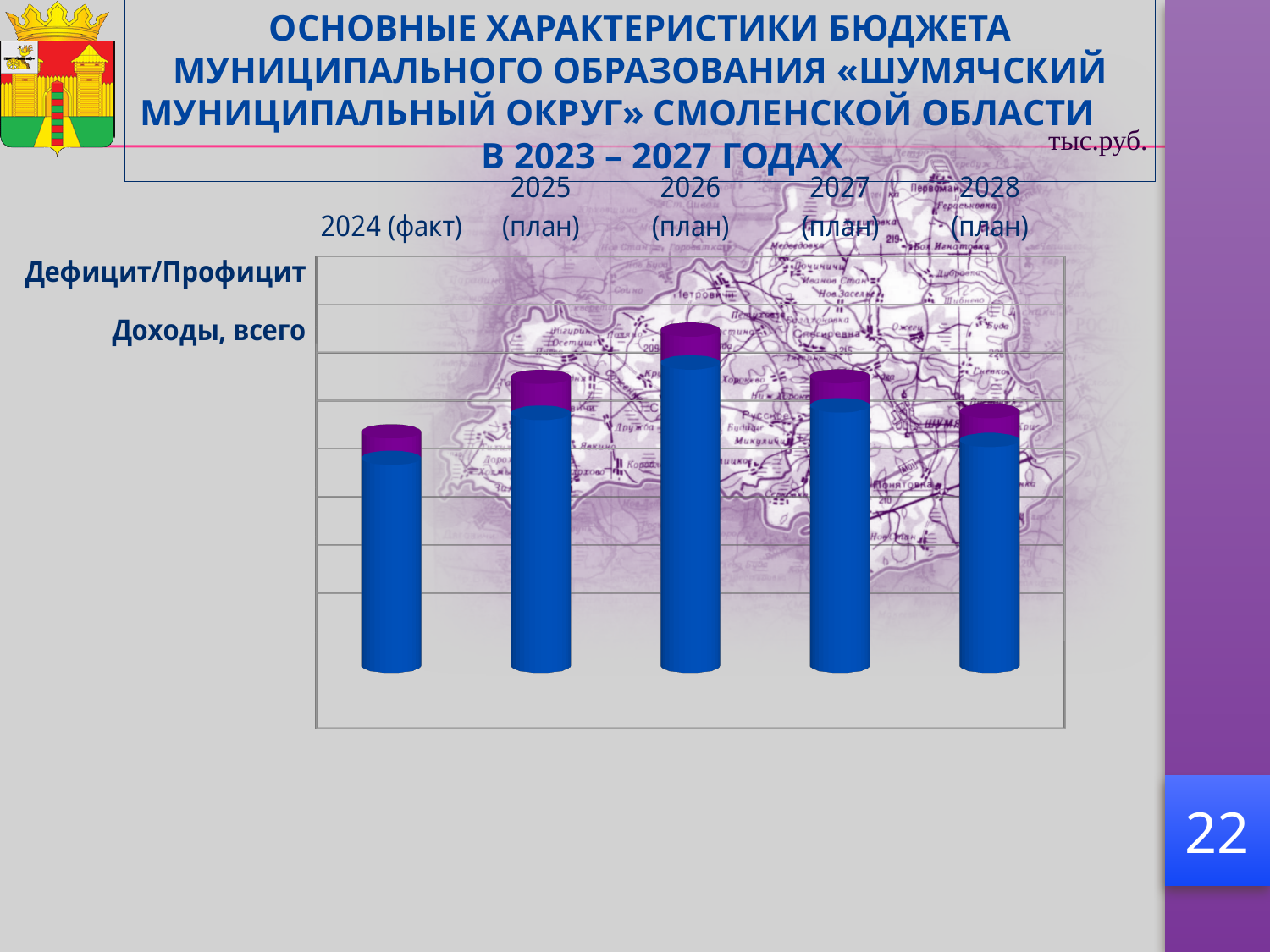
How many year categories are plotted on the chart? 5 What unit of measurement is indicated for the chart values? тыс.руб. Which bar is taller, 2025 (план) or 2028 (план)? 2025 (план) Which bar is taller, 2027 (план) or 2028 (план)? 2027 (план) Which year has the shortest bar on the chart? 2024 (факт) Which year has the tallest bar on the chart? 2026 (план) What kind of chart is shown on the slide? bar chart How do the bar heights change from 2026 (план) to 2028 (план)? they fall How do the bar heights change from 2024 (факт) to 2026 (план)? they rise Which bar is taller, 2024 (факт) or 2028 (план)? 2028 (план)